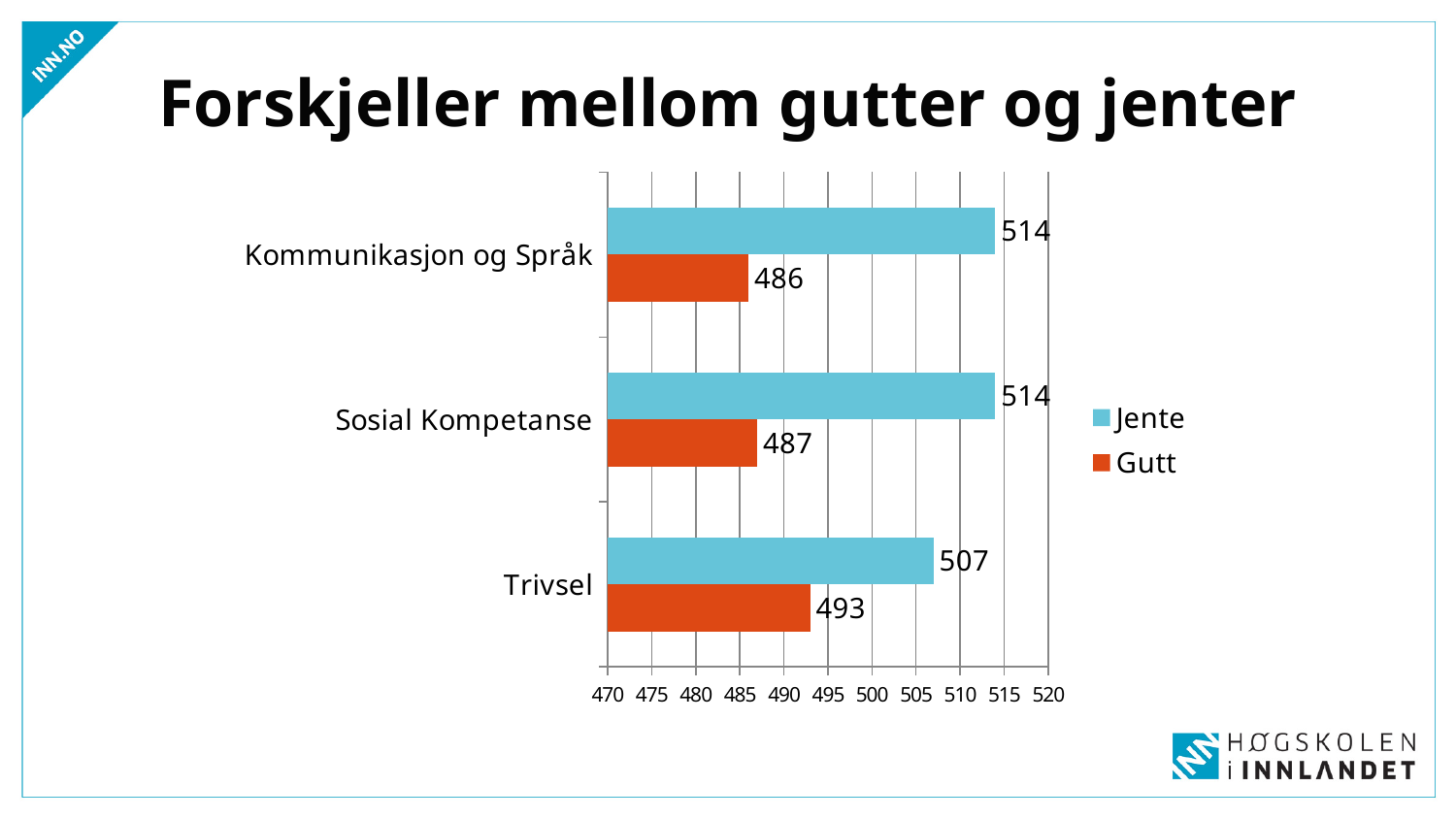
Which category has the lowest value for Gutt? Kommunikasjon og Språk What is the difference between Jente and Gutt in Trivsel? 14 What is the value for Jente in Kommunikasjon og Språk? 514 Which category has the lowest value for Jente? Trivsel How many categories are shown on the chart? 3 What is the value for Gutt in Trivsel? 493 Which is larger in Sosial Kompetanse, Jente or Gutt? Jente Which category has the highest value for Gutt? Trivsel What kind of chart is shown on the slide? Bar chart What is the difference between Jente and Gutt in Kommunikasjon og Språk? 28 How many series does the legend list? 2 What is the value for Gutt in Sosial Kompetanse? 487